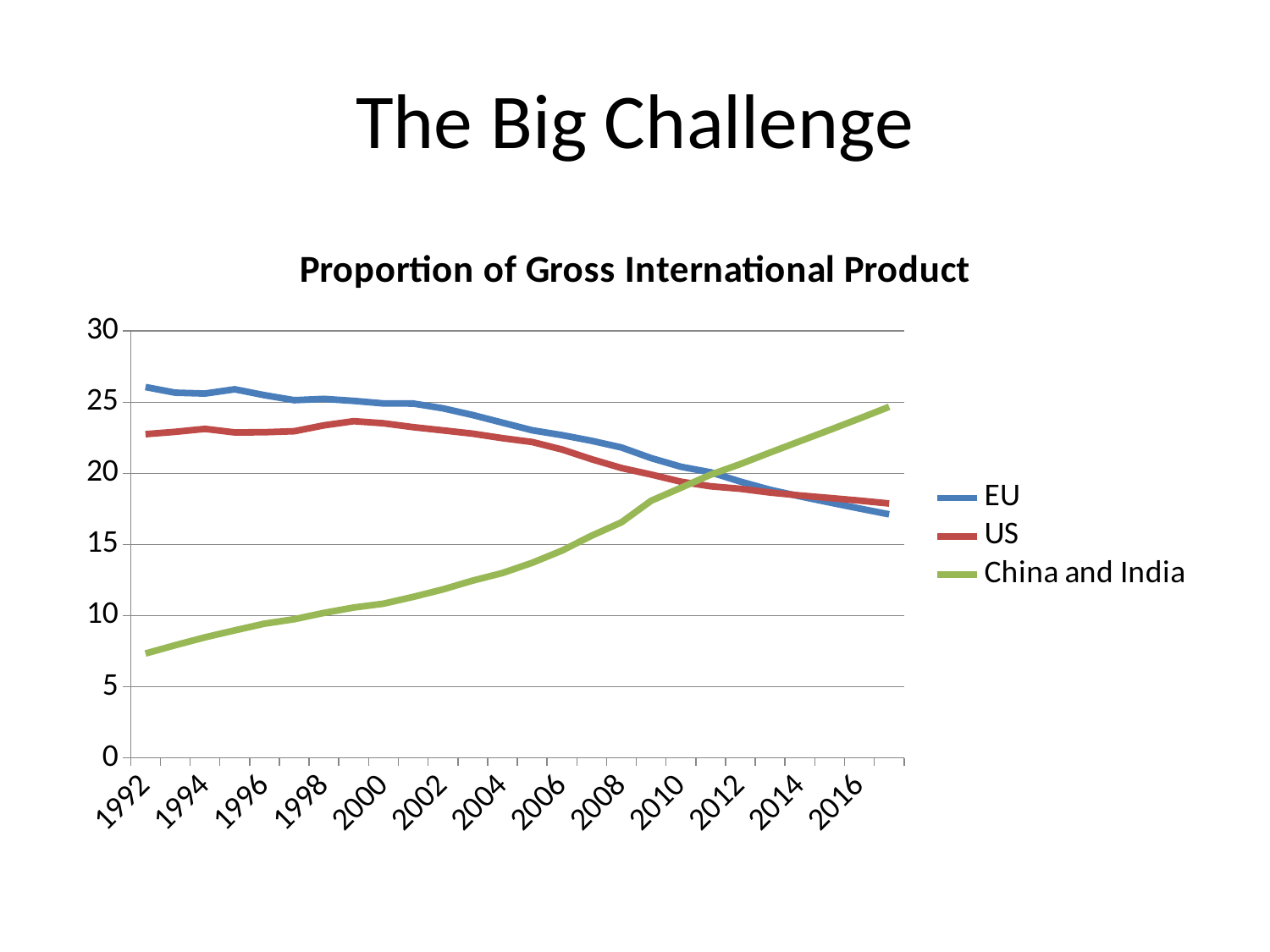
Which series does the legend show in green? China and India Which series has the highest value in 1992? EU Is the value for EU in 1992 greater or less than 25? greater Is the value for China and India in 1992 greater or less than 10? less In 2004, which is larger, the value for US or the value for China and India? US Does the China and India line rise or fall from 1992 to 2017? rise Does the EU line rise or fall from 1992 to 2017? fall Which series has the lowest value in 1992? China and India How many series does the legend list? 3 What kind of chart is shown on the slide? line chart Which series has the highest value at the end of the chart (2017)? China and India What is the title of the chart? Proportion of Gross International Product